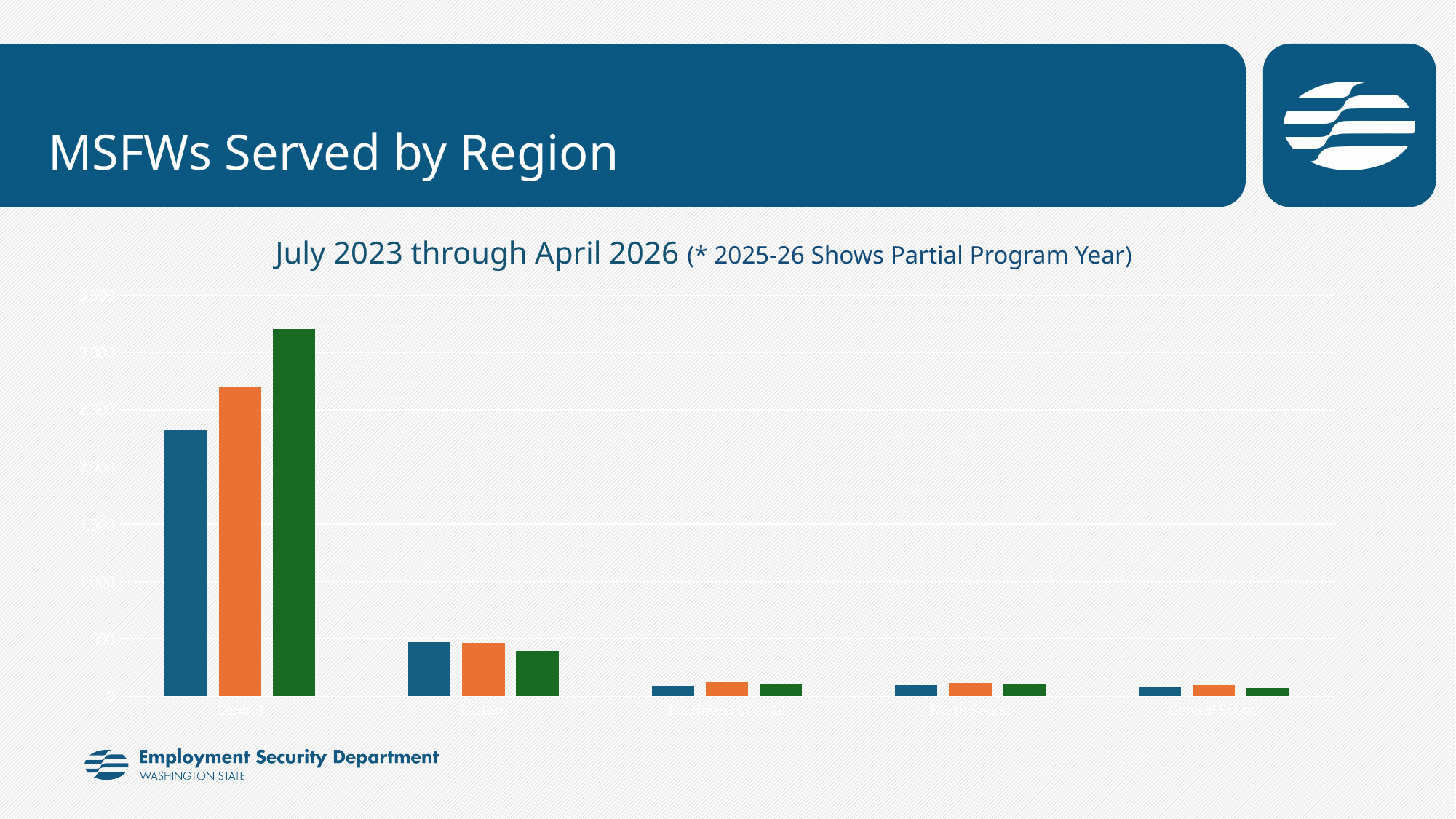
How many bars are plotted for each region category? 3 Is the value of the green bar for Central greater or less than 3,000? greater What is the title shown above the chart? July 2023 through April 2026 (* 2025-26 Shows Partial Program Year) Which region has higher values, Central or Eastern? Central Which region has the highest values in the chart? Central Do the values generally rise or fall moving from left to right across the regions? fall Is the value of the blue bar for Central greater or less than 2,000? greater What colours are the three bars in each region group, from left to right? blue, orange, green What kind of chart is shown on the slide? bar chart How many region categories are shown along the x axis of the chart? 5 Is the value of the blue bar for Eastern greater or less than 1,000? less